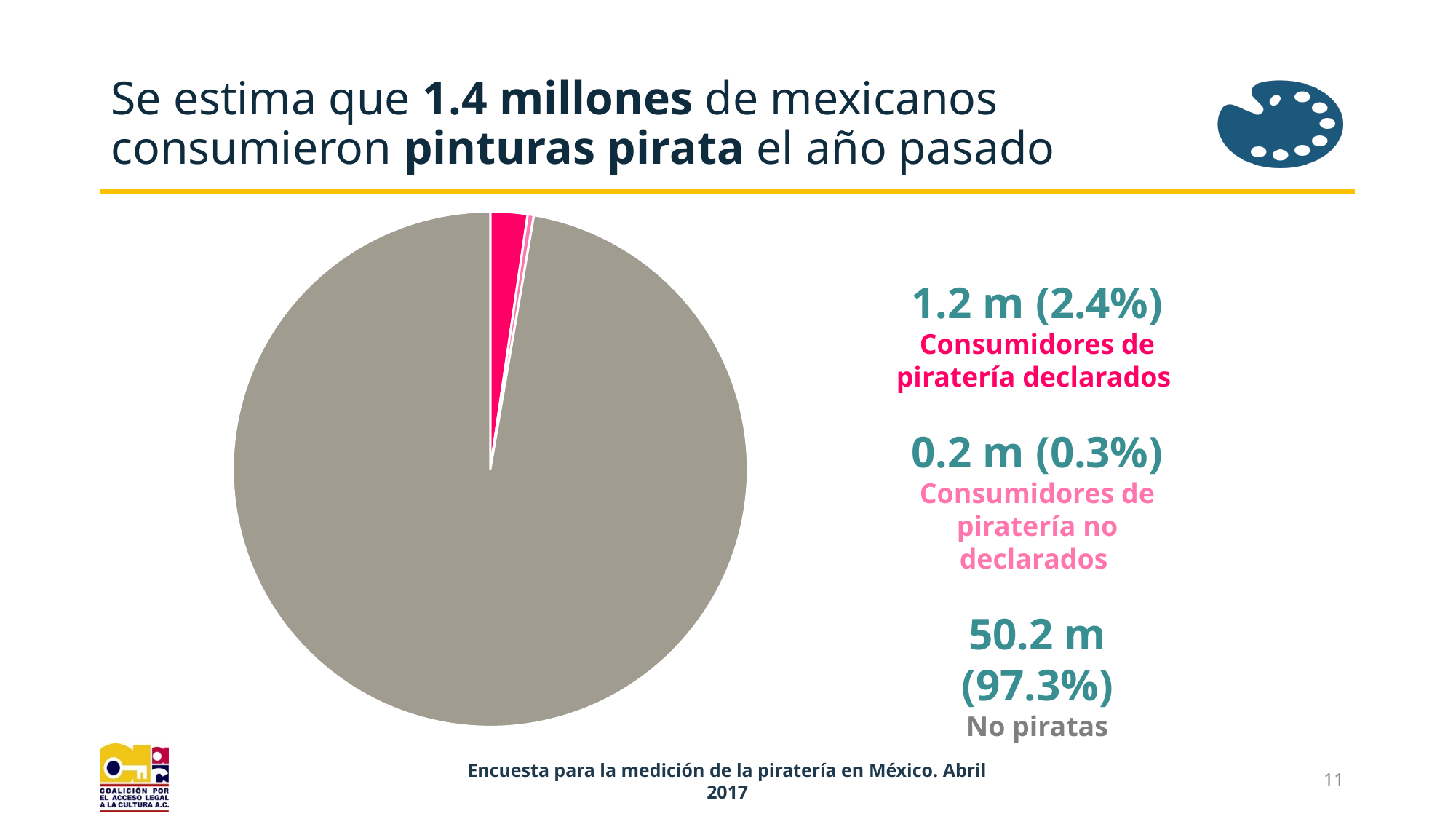
Which category has the largest slice of the pie? No piratas How many slices does the pie chart have? 3 Which category has the smallest slice of the pie? Consumidores de piratería no declarados How many people are labelled as 'Consumidores de piratería declarados'? 1.2 m What is the difference in millions between 'Consumidores de piratería declarados' and 'Consumidores de piratería no declarados'? 1.0 m What kind of chart is shown on the slide? pie chart How many people are labelled as 'Consumidores de piratería no declarados'? 0.2 m What share of the pie is labelled 'Consumidores de piratería declarados'? 2.4% What share of the pie is labelled 'Consumidores de piratería no declarados'? 0.3% What share of the pie is labelled 'No piratas'? 97.3% How many people are labelled as 'No piratas'? 50.2 m Which is larger, the slice for 'Consumidores de piratería declarados' or the slice for 'Consumidores de piratería no declarados'? Consumidores de piratería declarados